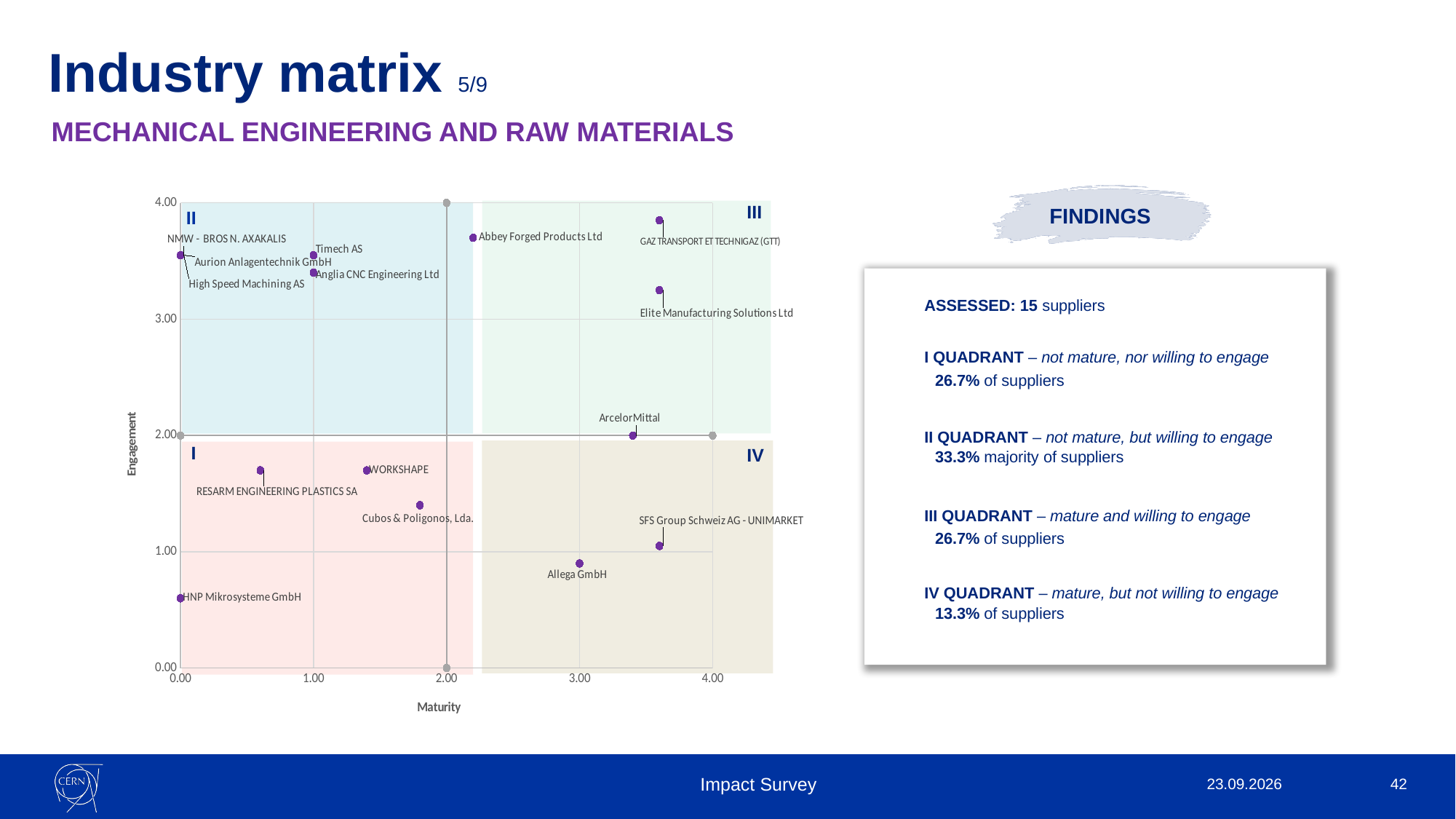
What is the label of the vertical axis of the chart? Engagement Which has the higher Engagement value, GAZ TRANSPORT ET TECHNIGAZ (GTT) or Elite Manufacturing Solutions Ltd? GAZ TRANSPORT ET TECHNIGAZ (GTT) Is the Maturity value for Cubos & Poligonos, Lda. greater or less than 2.00? less Is the Engagement value for GAZ TRANSPORT ET TECHNIGAZ (GTT) greater or less than 3.00? greater What kind of chart is shown on the slide? Scatter chart Which has the higher Engagement value, RESARM ENGINEERING PLASTICS SA or HNP Mikrosysteme GmbH? RESARM ENGINEERING PLASTICS SA Is the Engagement value for HNP Mikrosysteme GmbH greater or less than 1.00? less Which supplier has the lowest Engagement value on the chart? HNP Mikrosysteme GmbH What is the label of the horizontal axis of the chart? Maturity